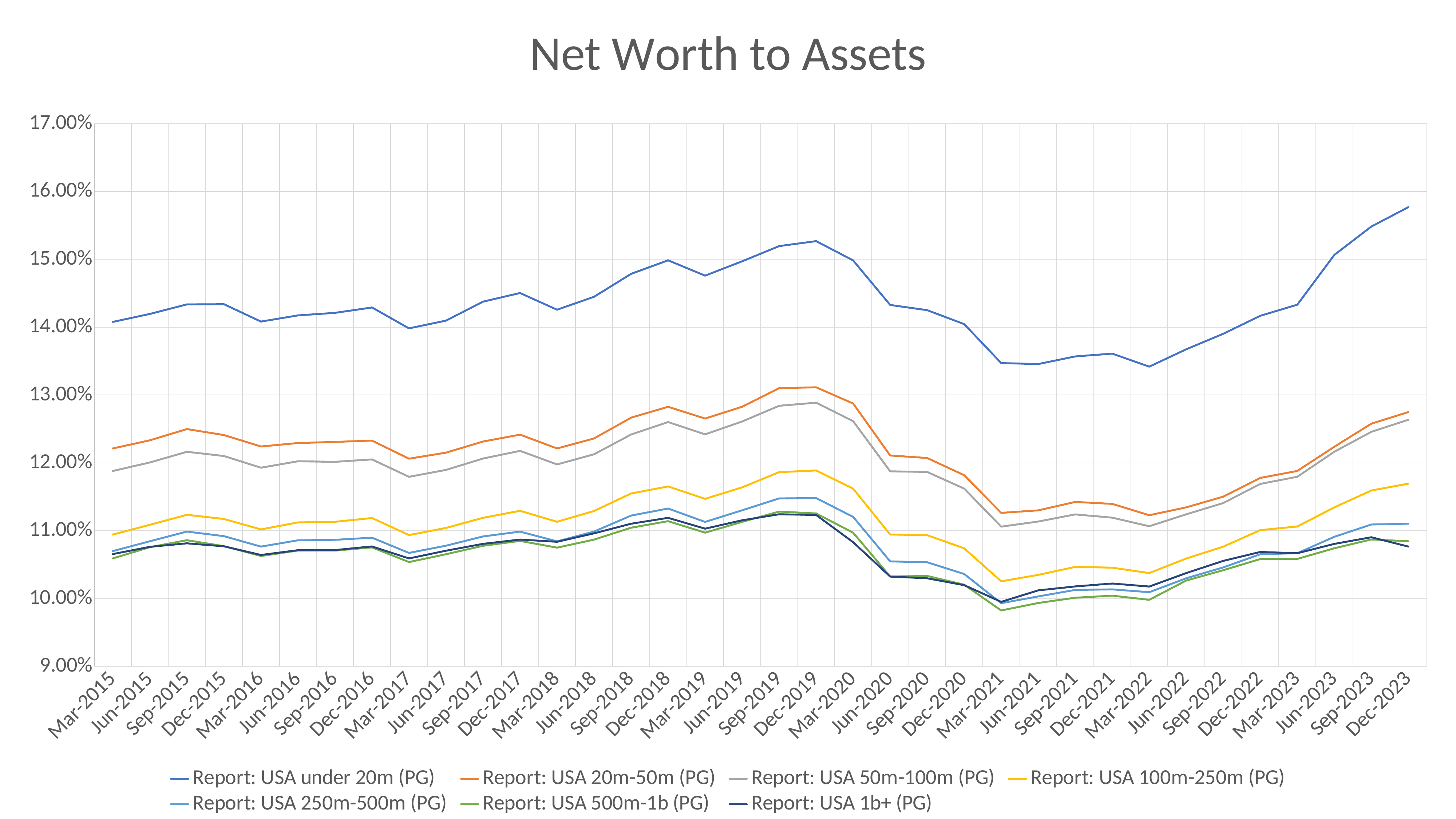
Which series has the highest value at Dec-2023? Report: USA under 20m (PG) Is the value for Report: USA under 20m (PG) at Mar-2022 greater or less than 14.00%? less What kind of chart is shown on the slide? line chart Is the value for Report: USA 500m-1b (PG) at Mar-2021 greater or less than 10.00%? less What is the title of the chart? Net Worth to Assets How many quarterly points are plotted along the x axis, from Mar-2015 to Dec-2023? 36 Which series has the lowest value at Mar-2021? Report: USA 500m-1b (PG) Is the value for Report: USA under 20m (PG) at Dec-2023 greater or less than 15.00%? greater At Dec-2019, which is larger: Report: USA 20m-50m (PG) or Report: USA 50m-100m (PG)? Report: USA 20m-50m (PG) How many series does the legend list? 7 Does the Report: USA under 20m (PG) line rise or fall from Mar-2022 to Dec-2023? rise